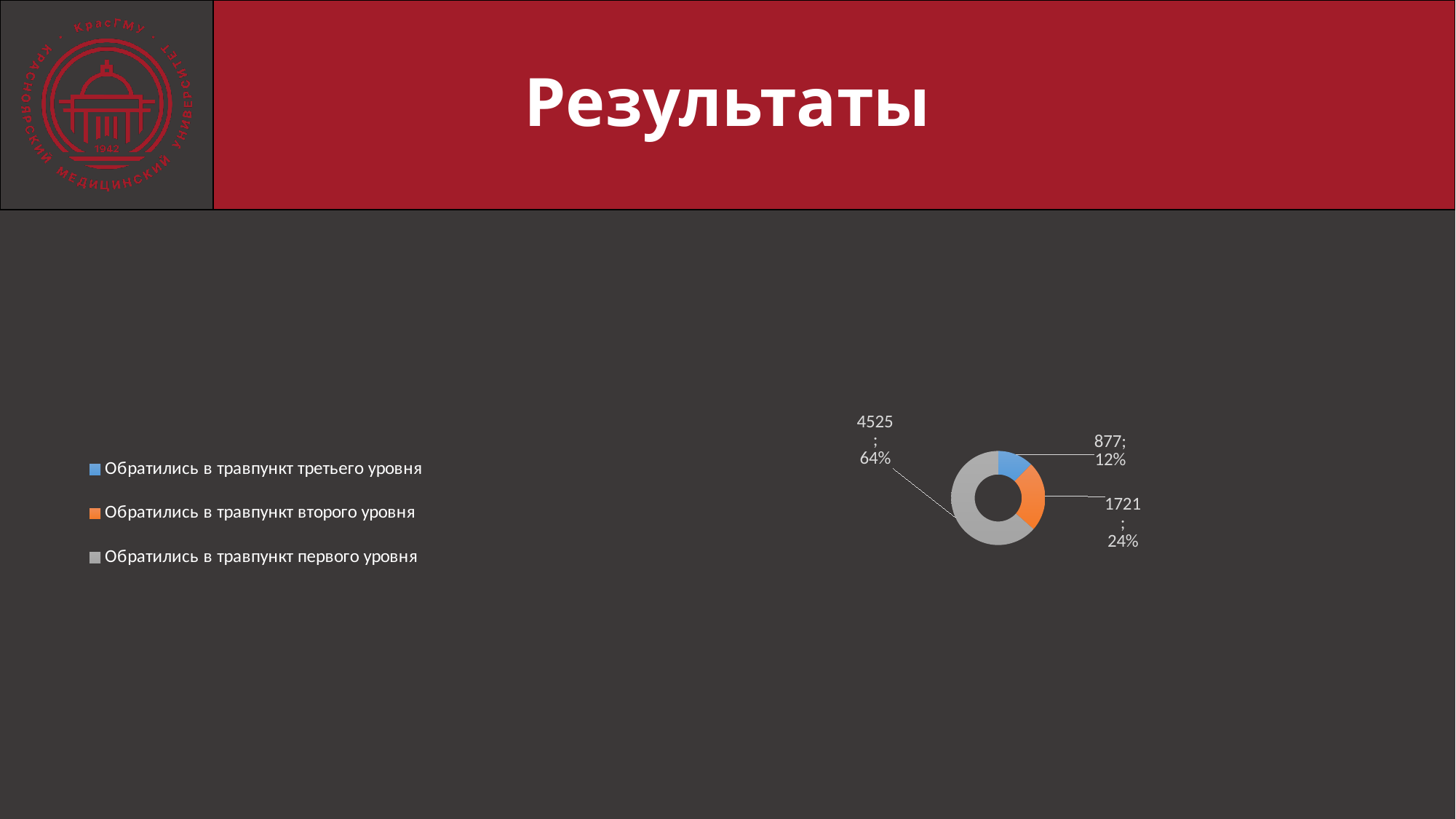
What is the value for "Обратились в травпункт первого уровня"? 4525 What share of the chart does "Обратились в травпункт третьего уровня" take? 12% What is the value for "Обратились в травпункт второго уровня"? 1721 What is the value for "Обратились в травпункт третьего уровня"? 877 Which is larger: the value for "Обратились в травпункт второго уровня" or "Обратились в травпункт третьего уровня"? Обратились в травпункт второго уровня What kind of chart is shown on the slide? Doughnut chart What share of the chart does "Обратились в травпункт первого уровня" take? 64% How many categories does the chart show? 3 Which category has the largest value? Обратились в травпункт первого уровня Which category has the smallest value? Обратились в травпункт третьего уровня What is the difference between the values for "Обратились в травпункт первого уровня" and "Обратились в травпункт второго уровня"? 2804 What colour represents "Обратились в травпункт второго уровня" in the chart? Orange